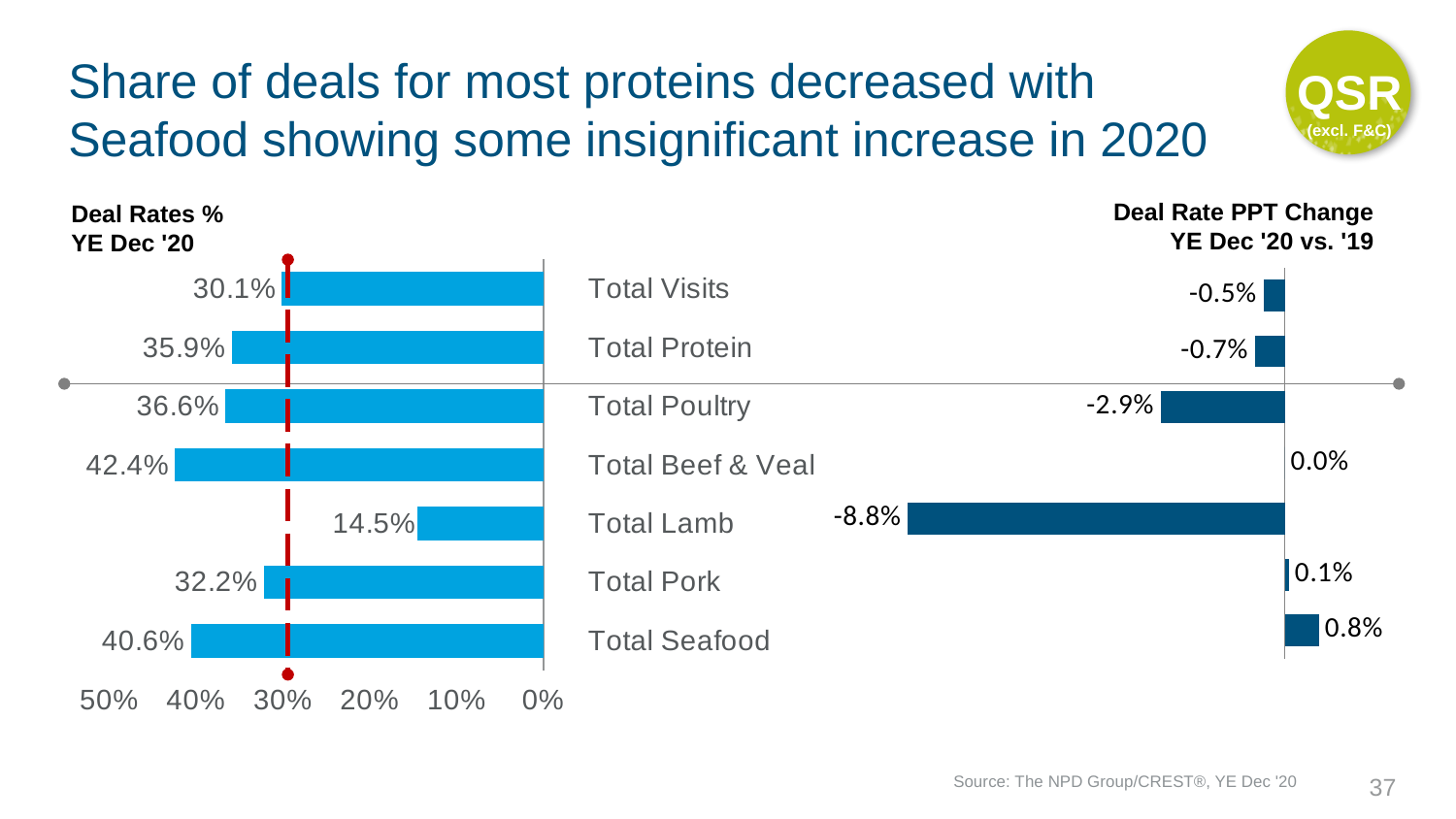
In the Deal Rate PPT Change YE Dec '20 vs. '19 chart, what is the change for Total Seafood? 0.8% In the Deal Rates % YE Dec '20 chart, which category has the lowest deal rate? Total Lamb What kind of chart is the Deal Rates % YE Dec '20 chart? Bar chart In the Deal Rates % YE Dec '20 chart, which category has the highest deal rate? Total Beef & Veal In the Deal Rates % YE Dec '20 chart, what is the deal rate for Total Lamb? 14.5% In the Deal Rates % YE Dec '20 chart, what is the deal rate for Total Beef & Veal? 42.4% In the Deal Rates % YE Dec '20 chart, what is the difference between the deal rates for Total Seafood and Total Pork? 8.4% In the Deal Rate PPT Change YE Dec '20 vs. '19 chart, which category shows the largest increase? Total Seafood In the Deal Rates % YE Dec '20 chart, which has a higher deal rate, Total Poultry or Total Protein? Total Poultry How many categories are shown in the Deal Rates % YE Dec '20 chart? 7 In the Deal Rate PPT Change YE Dec '20 vs. '19 chart, which category shows the largest decrease? Total Lamb In the Deal Rate PPT Change YE Dec '20 vs. '19 chart, what is the change for Total Poultry? -2.9%